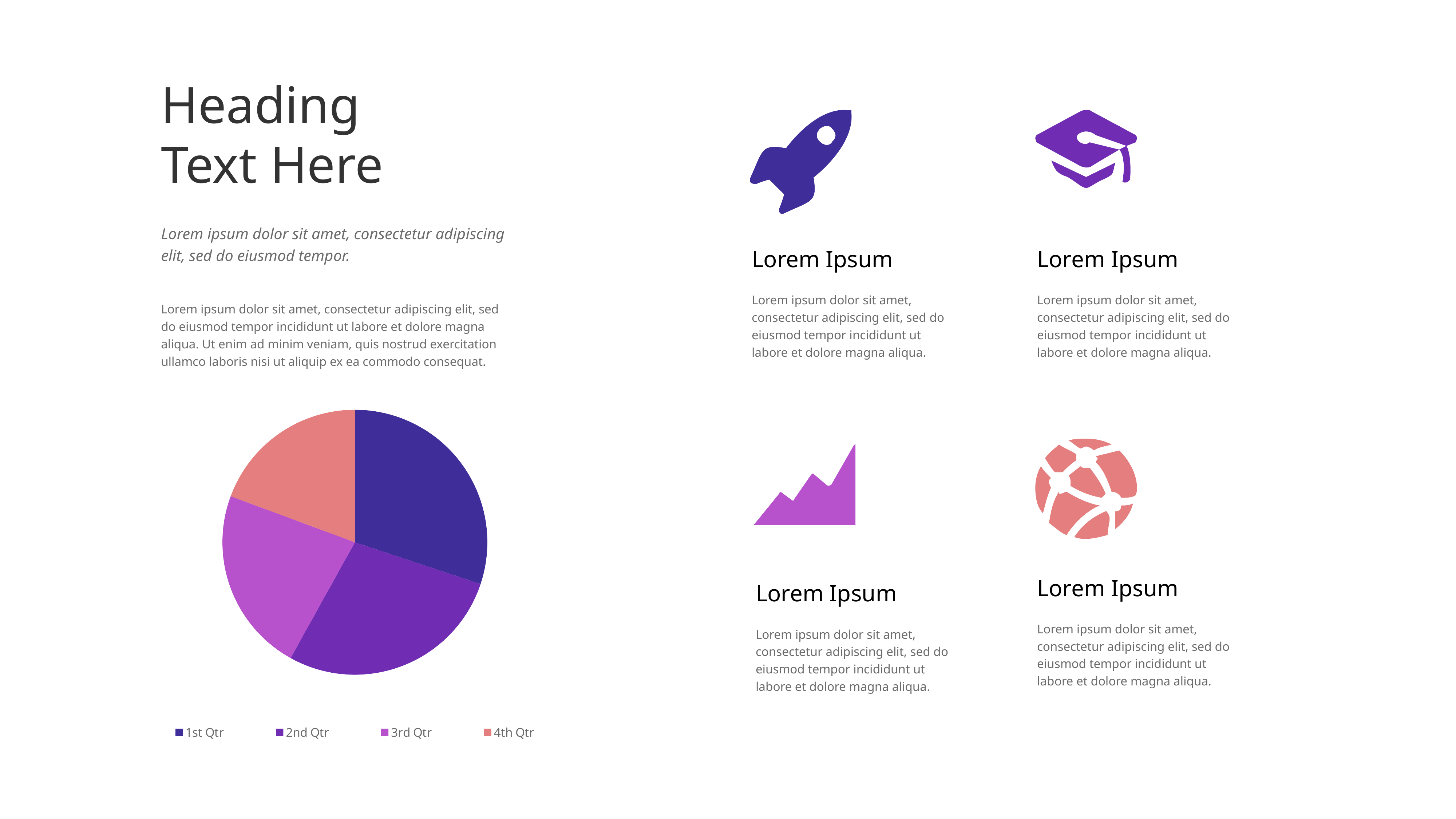
How many slices does the pie chart have? 4 In the pie chart, which slice is larger: 1st Qtr or 4th Qtr? 1st Qtr In the pie chart, which slice is larger: 2nd Qtr or 4th Qtr? 2nd Qtr Which legend entry of the pie chart is shown in a salmon/pink colour? 4th Qtr Which category has the smallest slice in the pie chart? 4th Qtr What are the legend entries of the pie chart, in order? 1st Qtr, 2nd Qtr, 3rd Qtr, 4th Qtr How many entries does the legend of the pie chart list? 4 In the pie chart, which slice is larger: 3rd Qtr or 4th Qtr? 3rd Qtr What kind of chart is shown on the slide? pie chart